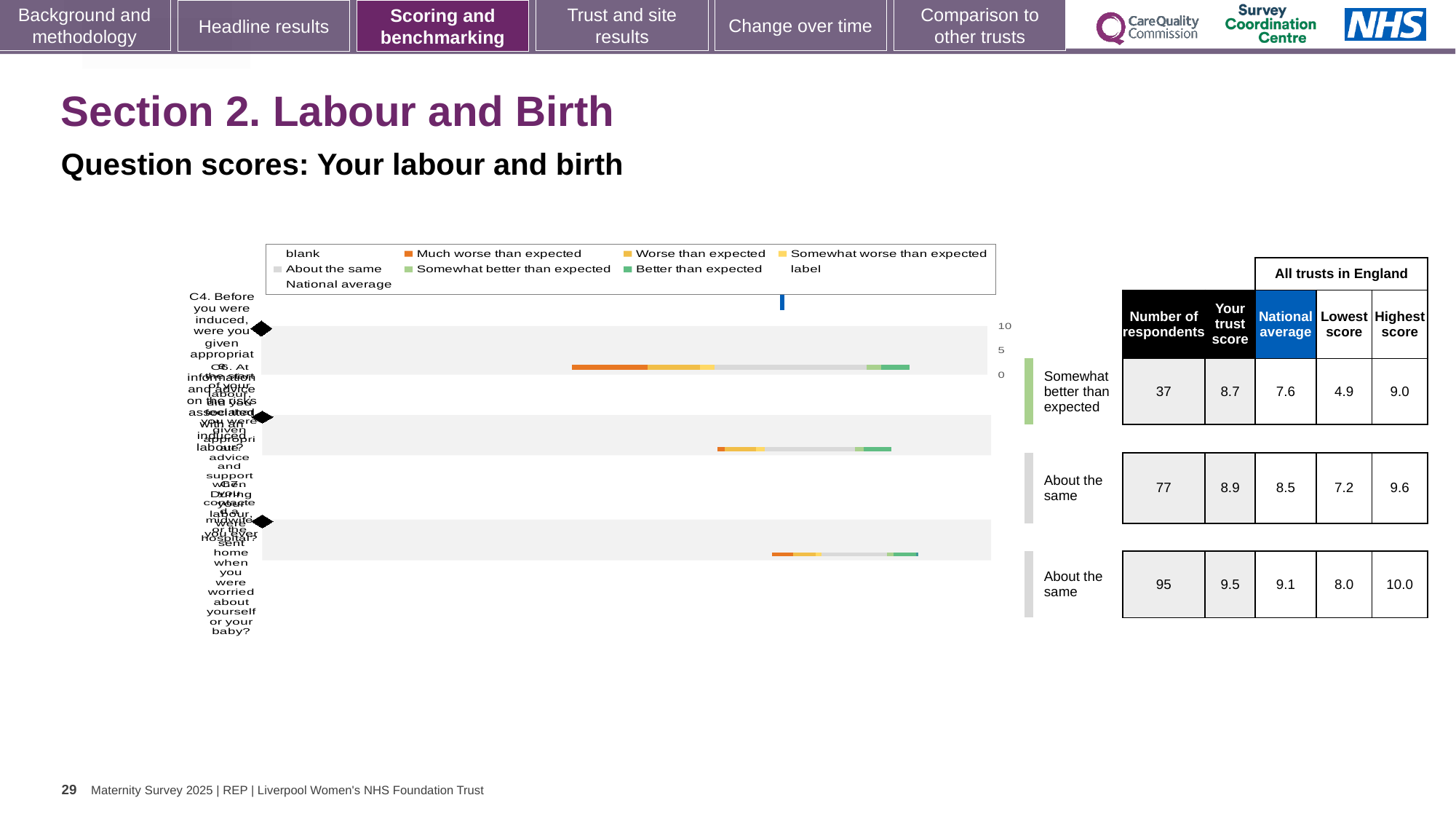
Which row of the table has the highest number of respondents? the bottom row (95) What benchmark rating is shown next to the bottom row of the table? About the same In the table, what is the lowest score for the bottom row? 8.0 In the table, what is the trust score for the top row (rated 'Somewhat better than expected')? 8.7 In the table, what is the number of respondents for the bottom row? 95 In the table, what is the number of respondents for the top row (rated 'Somewhat better than expected')? 37 What is the difference between the trust score and the national average for the top row of the table? 1.1 For the middle row of the table, which is larger: the trust score or the national average? the trust score (8.9) In the table, what is the highest score for the middle row? 9.6 In the table, what is the national average for the top row (rated 'Somewhat better than expected')? 7.6 What kind of chart is shown on the slide? bar chart How many bars (question rows) does the chart show? 3